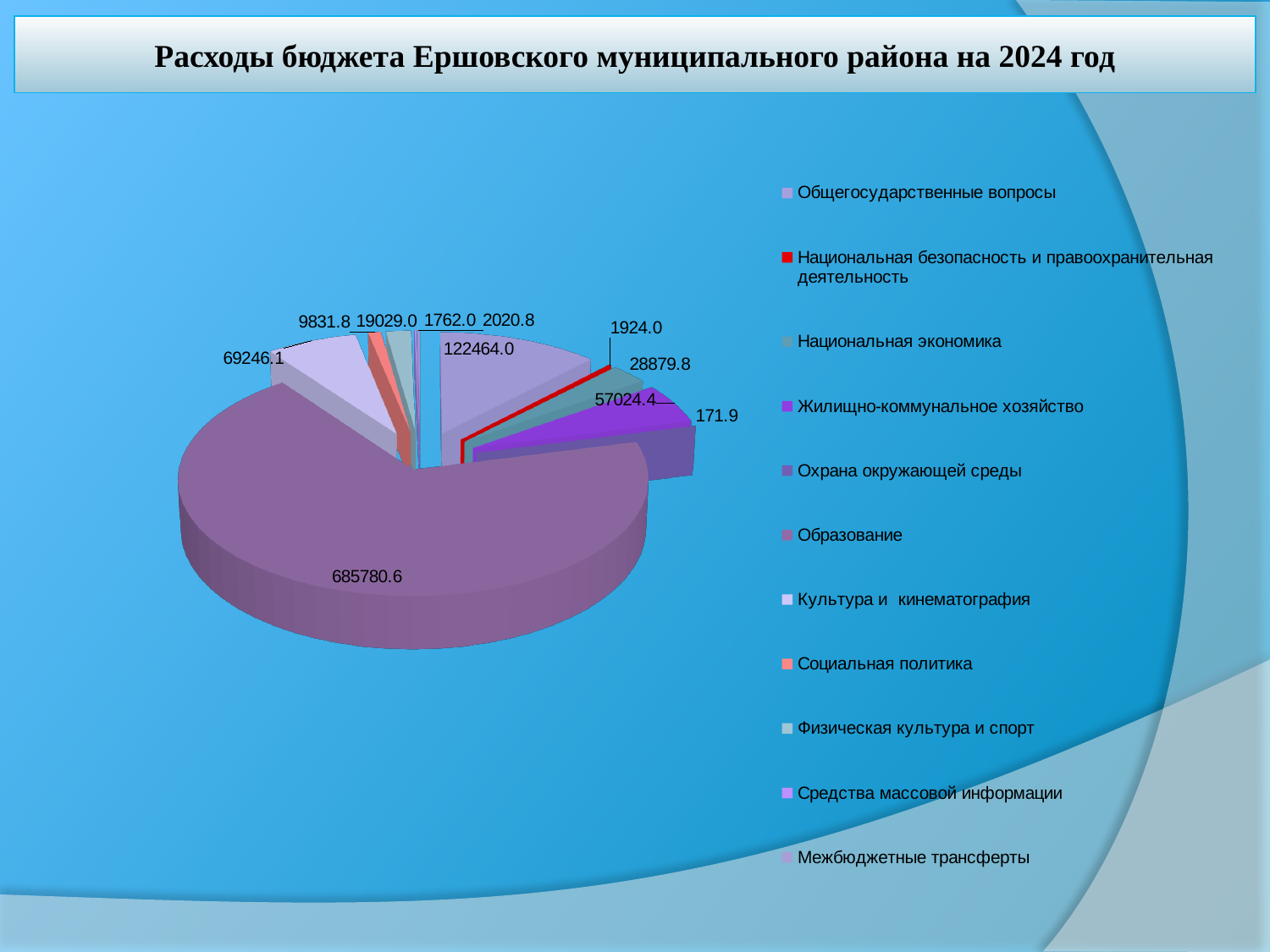
What is the value for Общегосударственные вопросы? 122464.0 What is the value for Национальная экономика? 28879.8 What is the value for Культура и кинематография? 69246.1 What is the value of the largest slice in the pie chart? 685780.6 What kind of chart is shown on the slide? Pie chart What is the smallest value labelled on the pie chart? 171.9 What is the value for Жилищно-коммунальное хозяйство? 57024.4 Which category has the largest slice of the pie chart? Образование What is the title of the chart on the slide? Расходы бюджета Ершовского муниципального района на 2024 год What is the difference between the value for Общегосударственные вопросы (122464.0) and the value for Культура и кинематография (69246.1)? 53217.9 How many categories does the legend of the pie chart list? 11 Which is larger, the value for Общегосударственные вопросы or the value for Культура и кинематография? Общегосударственные вопросы